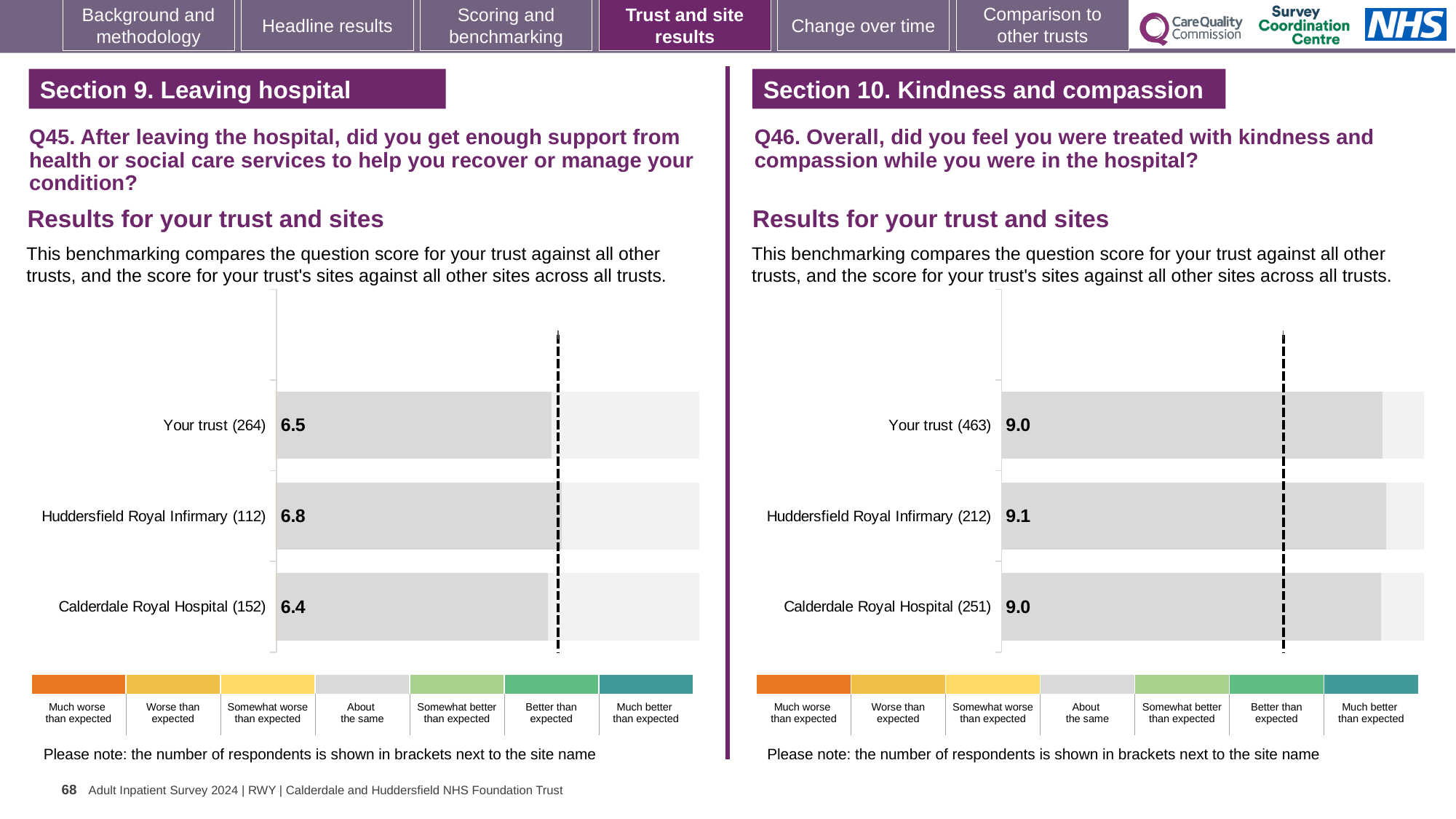
In the Q46 chart on the right, what is the score for Calderdale Royal Hospital (251)? 9.0 In the Q46 chart on the right, what is the difference between the scores for Huddersfield Royal Infirmary and Your trust? 0.1 In the Q45 chart on the left, what is the score for Calderdale Royal Hospital (152)? 6.4 In the Q45 chart on the left, what is the score for Your trust (264)? 6.5 In the Q45 chart on the left, what is the difference between the scores for Huddersfield Royal Infirmary and Calderdale Royal Hospital? 0.4 In the Q45 chart on the left, which site or trust has the highest score? Huddersfield Royal Infirmary (112) In the Q46 chart on the right, what is the score for Your trust (463)? 9.0 In the Q45 chart on the left, which site or trust has the lowest score? Calderdale Royal Hospital (152) In the Q46 chart on the right, how many bars are plotted? 3 What kind of chart is the Q45 chart on the left? Bar chart In the Q46 chart on the right, what is the score for Huddersfield Royal Infirmary (212)? 9.1 In the Q45 chart on the left, what is the score for Huddersfield Royal Infirmary (112)? 6.8